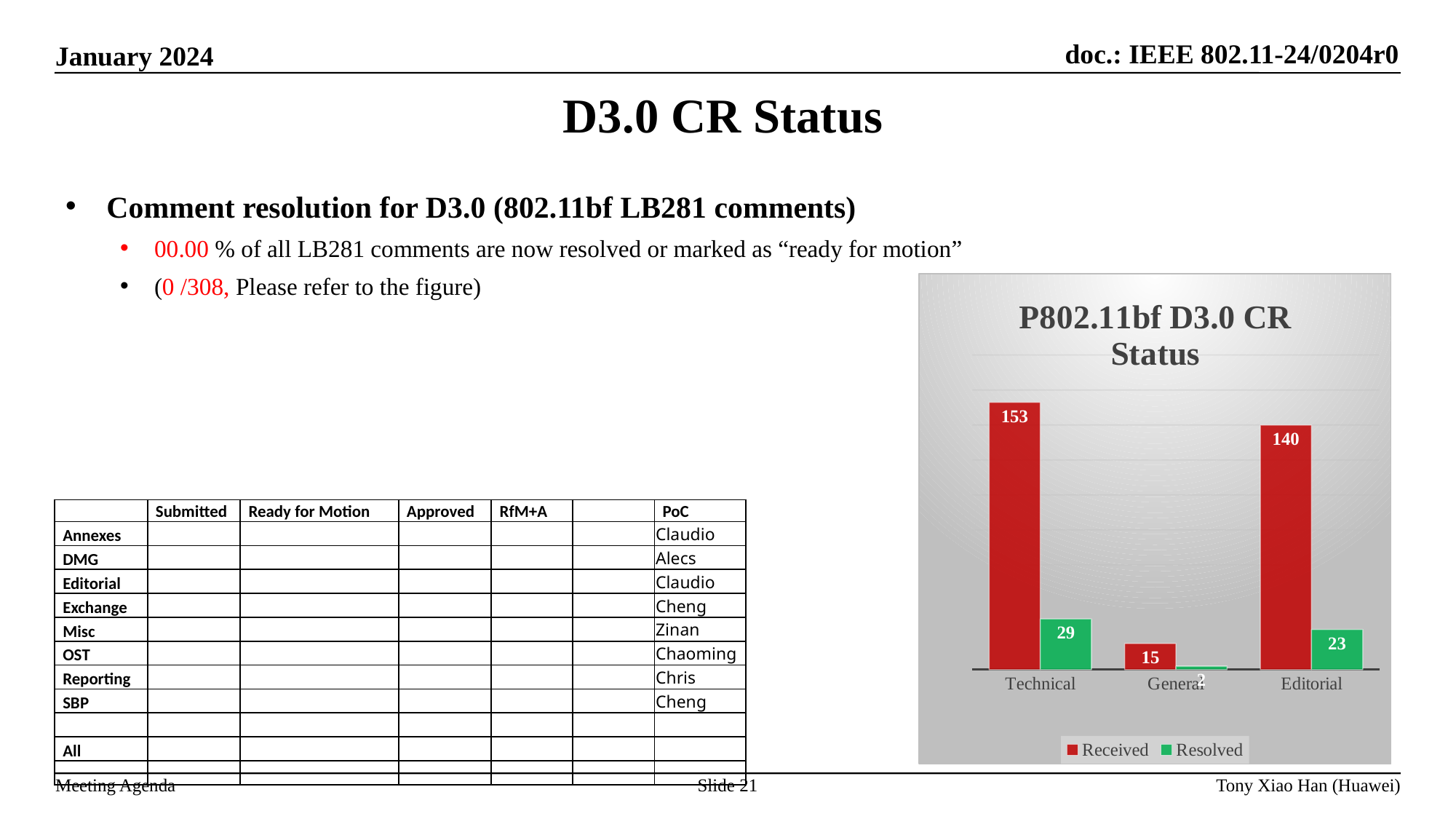
In the P802.11bf D3.0 CR Status chart, which category has the highest number of Received comments? Technical How many series does the legend of the P802.11bf D3.0 CR Status chart list? 2 In the P802.11bf D3.0 CR Status chart, how many comments were Received for General? 15 In the P802.11bf D3.0 CR Status chart, how many comments were Received for Technical? 153 In the P802.11bf D3.0 CR Status chart, what is the difference between the Received comments for Technical and Editorial? 13 In the P802.11bf D3.0 CR Status chart, which has more Resolved comments, Technical or Editorial? Technical How many categories are shown on the x axis of the P802.11bf D3.0 CR Status chart? 3 In the P802.11bf D3.0 CR Status chart, how many comments were Received for Editorial? 140 In the P802.11bf D3.0 CR Status chart, which category has the lowest number of Received comments? General In the P802.11bf D3.0 CR Status chart, how many comments were Resolved for Technical? 29 In the P802.11bf D3.0 CR Status chart, how many comments were Resolved for Editorial? 23 What kind of chart is the P802.11bf D3.0 CR Status chart? Bar chart